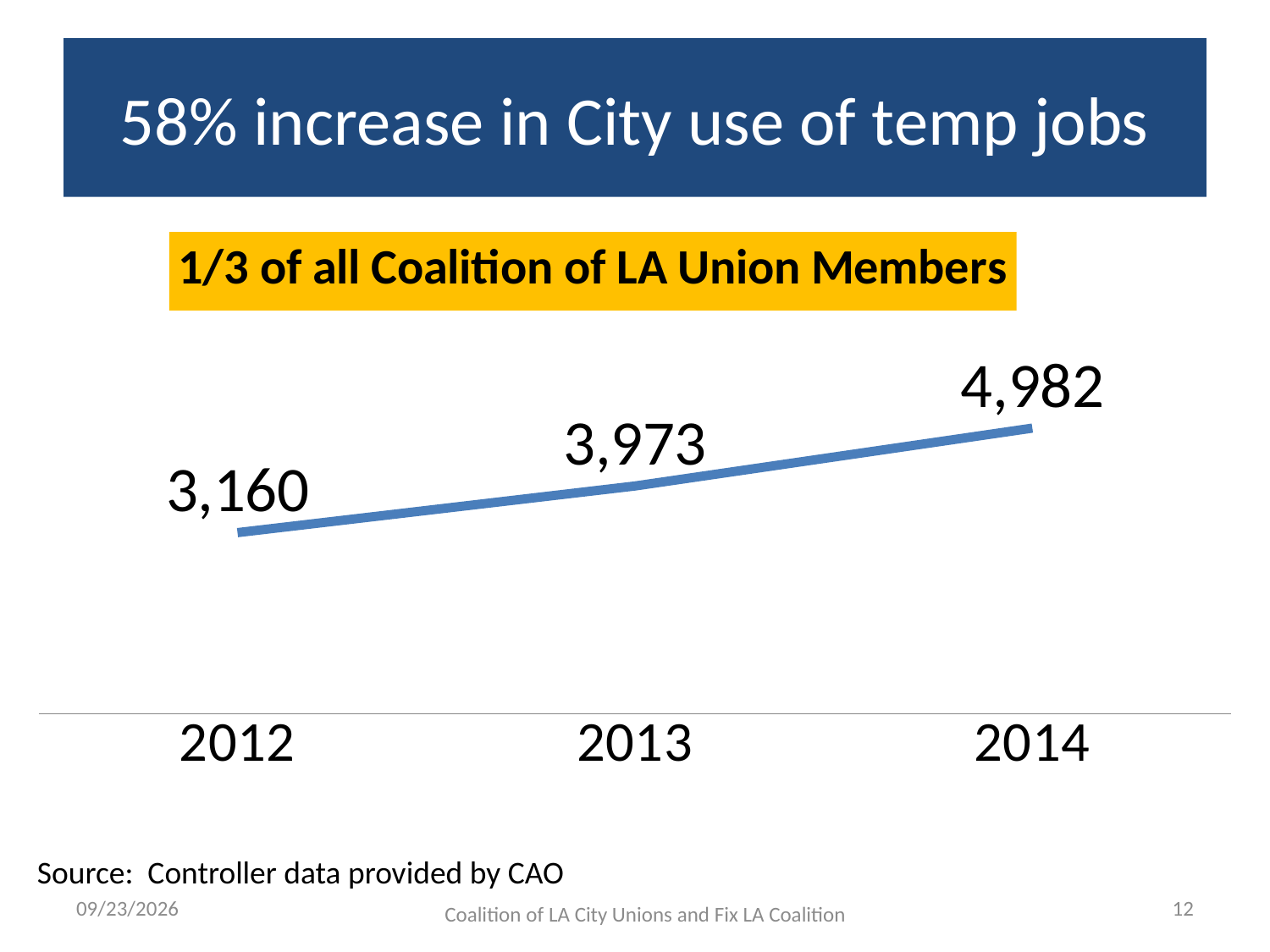
Which is larger, the value for 2013 or the value for 2014? 2014 Do the values rise or fall from 2012 to 2014? rise Which year has the highest value? 2014 What is the difference between the values for 2013 and 2012? 813 What is the title of the slide containing the chart? 58% increase in City use of temp jobs What is the value for 2014? 4,982 What is the value for 2013? 3,973 What is the difference between the values for 2014 and 2012? 1,822 What is the value for 2012? 3,160 How many years are plotted on the chart? 3 Which year has the lowest value? 2012 What kind of chart is shown on the slide? line chart